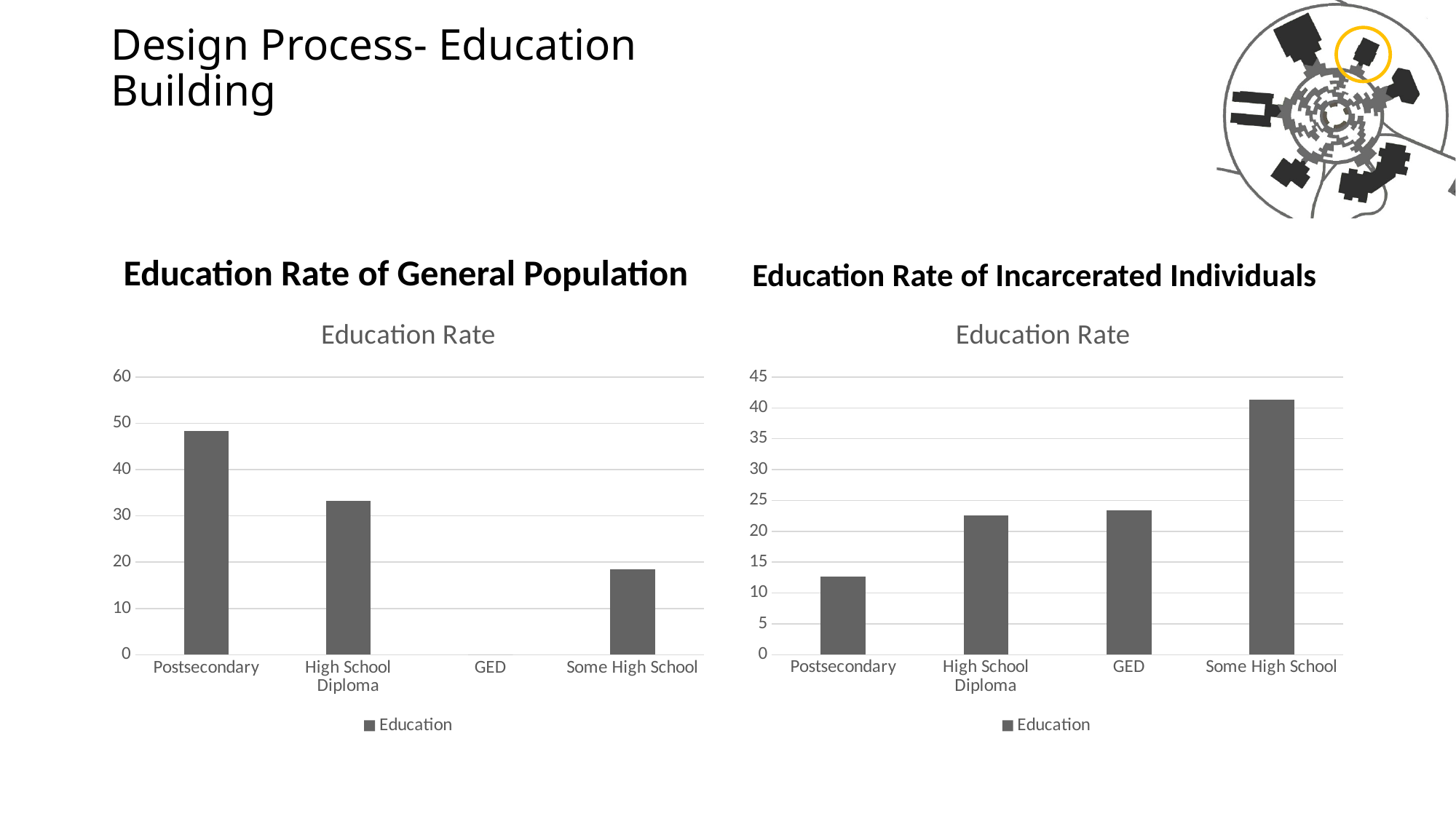
In the Education Rate of General Population chart, is the value for Postsecondary greater or less than 40? greater In the Education Rate of Incarcerated Individuals chart, which category has the highest value? Some High School In the Education Rate of Incarcerated Individuals chart, which category has the lowest value? Postsecondary What kind of chart is the Education Rate of General Population chart? bar chart How many categories are shown on the x axis of the Education Rate of Incarcerated Individuals chart? 4 In the Education Rate of General Population chart, which category has the highest value? Postsecondary In the Education Rate of General Population chart, is the value for Some High School greater or less than 20? less In the Education Rate of General Population chart, which is larger, the value for High School Diploma or the value for Some High School? High School Diploma What is the name of the series shown in the legend of the Education Rate of Incarcerated Individuals chart? Education How many series does the legend of the Education Rate of General Population chart list? 1 In the Education Rate of Incarcerated Individuals chart, is the value for Postsecondary greater or less than 15? less